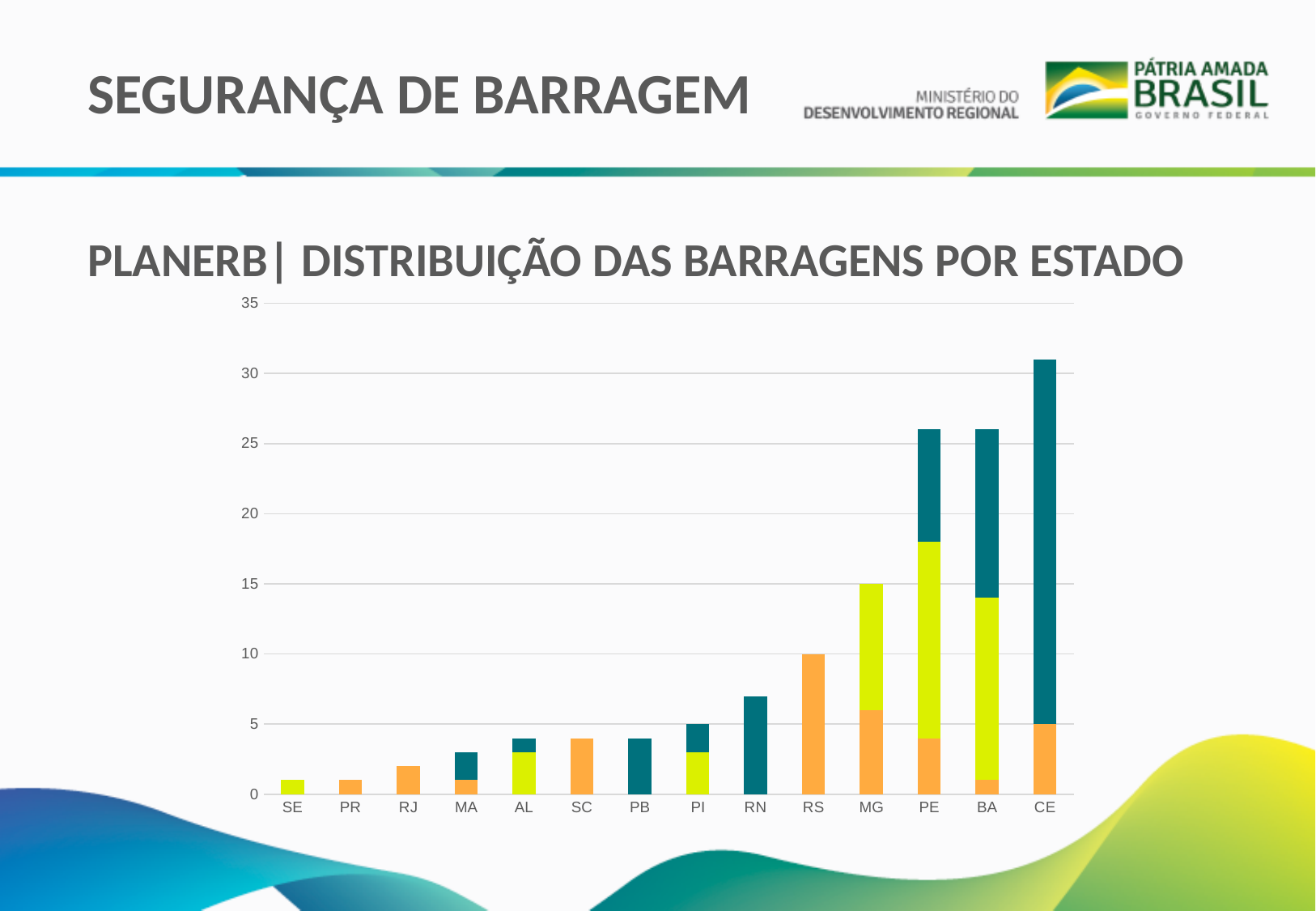
What is the title of the chart? PLANERB| DISTRIBUIÇÃO DAS BARRAGENS POR ESTADO Is the total value for SC greater or less than 5? less Is the total value for CE greater or less than 30? greater What is the total value of the bar for RS? 10 Do the bar totals generally rise or fall from left to right along the x axis? rise How many states are shown on the x axis of the chart? 14 What kind of chart is shown on the slide? bar chart Which state has the tallest bar in the chart? CE What is the total value of the bar for MG? 15 Is the total value for PE greater or less than 25? greater Which bar is taller, the one for RS or the one for RN? RS